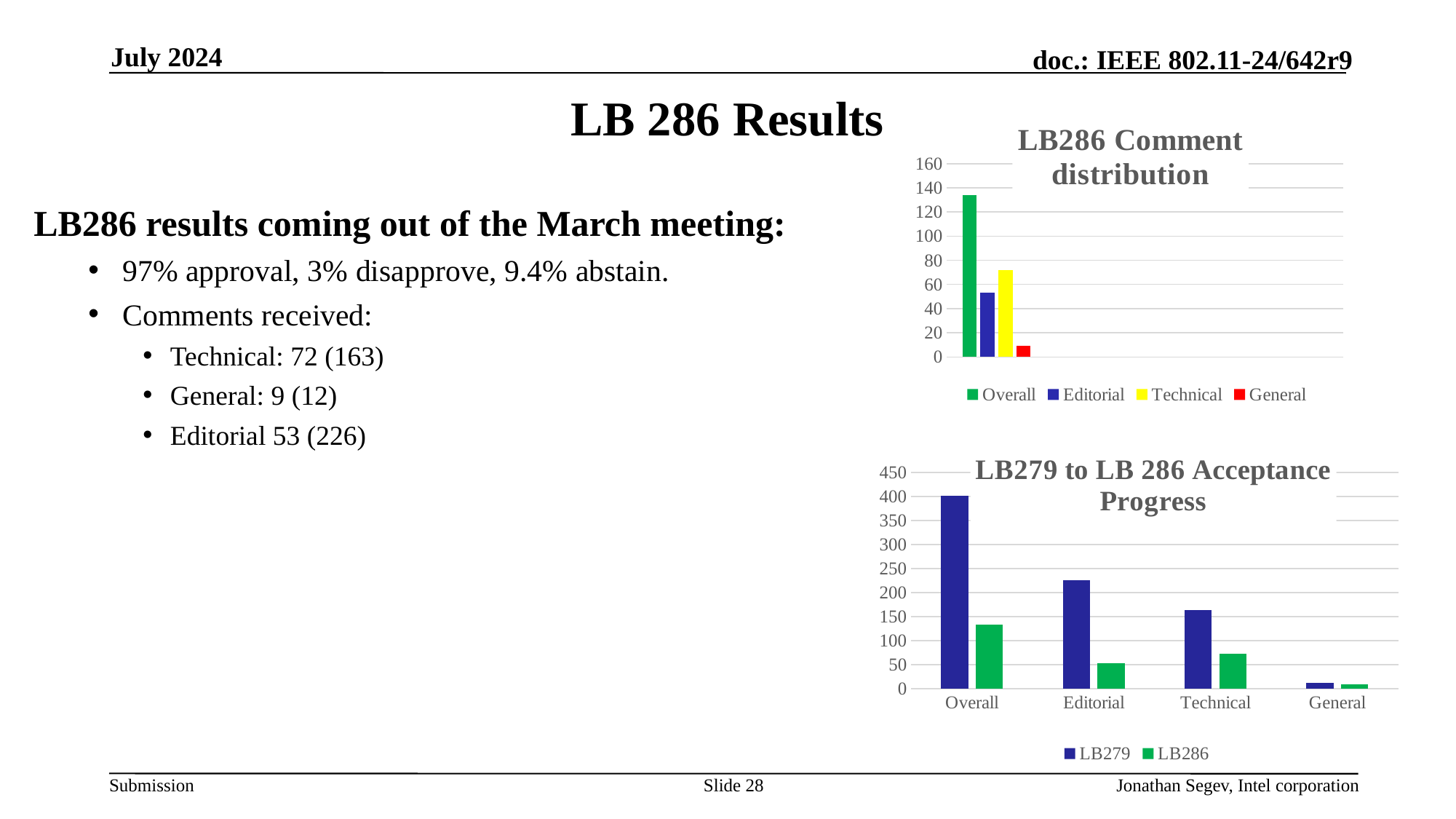
In the LB286 Comment distribution chart, how many entries does the legend list? 4 In the LB279 to LB 286 Acceptance Progress chart, for Technical, which series is larger, LB279 or LB286? LB279 In the LB286 Comment distribution chart, which category has the lowest bar? General In the LB286 Comment distribution chart, what kind of chart is shown? bar chart In the LB279 to LB 286 Acceptance Progress chart, how many categories are shown on the x axis? 4 In the LB286 Comment distribution chart, what colour is the Technical bar? yellow In the LB279 to LB 286 Acceptance Progress chart, which category has the highest LB279 value? Overall In the LB286 Comment distribution chart, which is larger, Editorial or Technical? Technical In the LB279 to LB 286 Acceptance Progress chart, is the LB279 value for Editorial greater or less than 200? greater In the LB286 Comment distribution chart, is the value for Technical greater or less than 60? greater In the LB286 Comment distribution chart, which category has the highest bar? Overall In the LB279 to LB 286 Acceptance Progress chart, how many series does the legend list? 2